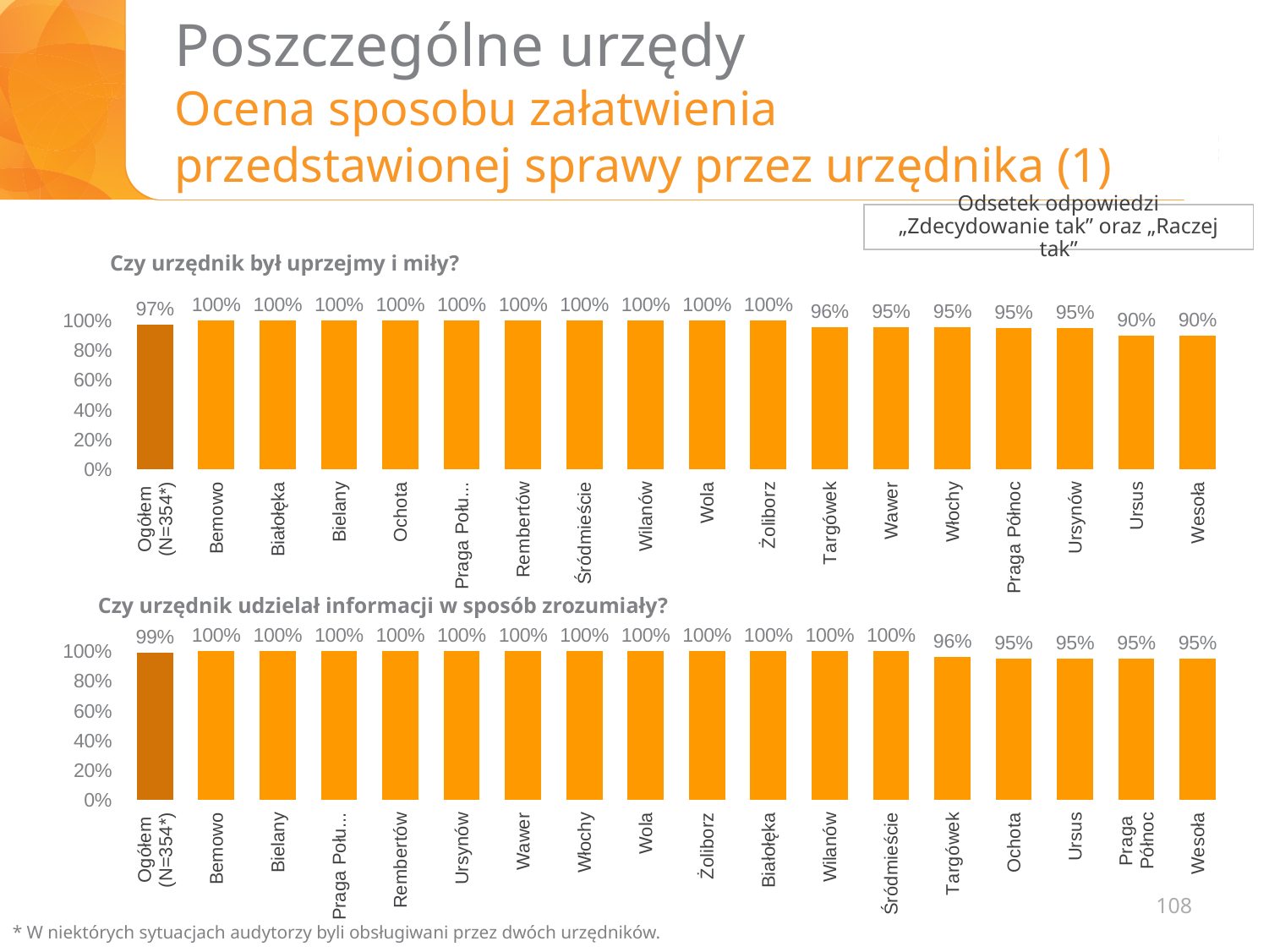
What type of chart is the chart "Czy urzędnik udzielał informacji w sposób zrozumiały?"? Bar chart In the chart "Czy urzędnik udzielał informacji w sposób zrozumiały?", what is the value for Ogółem (N=354*)? 99% In the chart "Czy urzędnik udzielał informacji w sposób zrozumiały?", what is the value for Ochota? 95% In the chart "Czy urzędnik był uprzejmy i miły?", do the values rise or fall from left to right after the Ogółem bar? Fall How many bars are shown in the chart "Czy urzędnik był uprzejmy i miły?"? 18 In the chart "Czy urzędnik udzielał informacji w sposób zrozumiały?", what is the difference between the values for Ogółem (N=354*) and Wesoła? 4% In the chart "Czy urzędnik był uprzejmy i miły?", what is the value for Ogółem (N=354*)? 97% In the chart "Czy urzędnik udzielał informacji w sposób zrozumiały?", what is the value for Targówek? 96% In the chart "Czy urzędnik był uprzejmy i miły?", what is the value for Targówek? 96% In the chart "Czy urzędnik był uprzejmy i miły?", what is the difference between the values for Bemowo and Wesoła? 10% In the chart "Czy urzędnik był uprzejmy i miły?", what is the value for Ursus? 90% In the chart "Czy urzędnik był uprzejmy i miły?", which is larger, the value for Wawer or the value for Ursus? Wawer